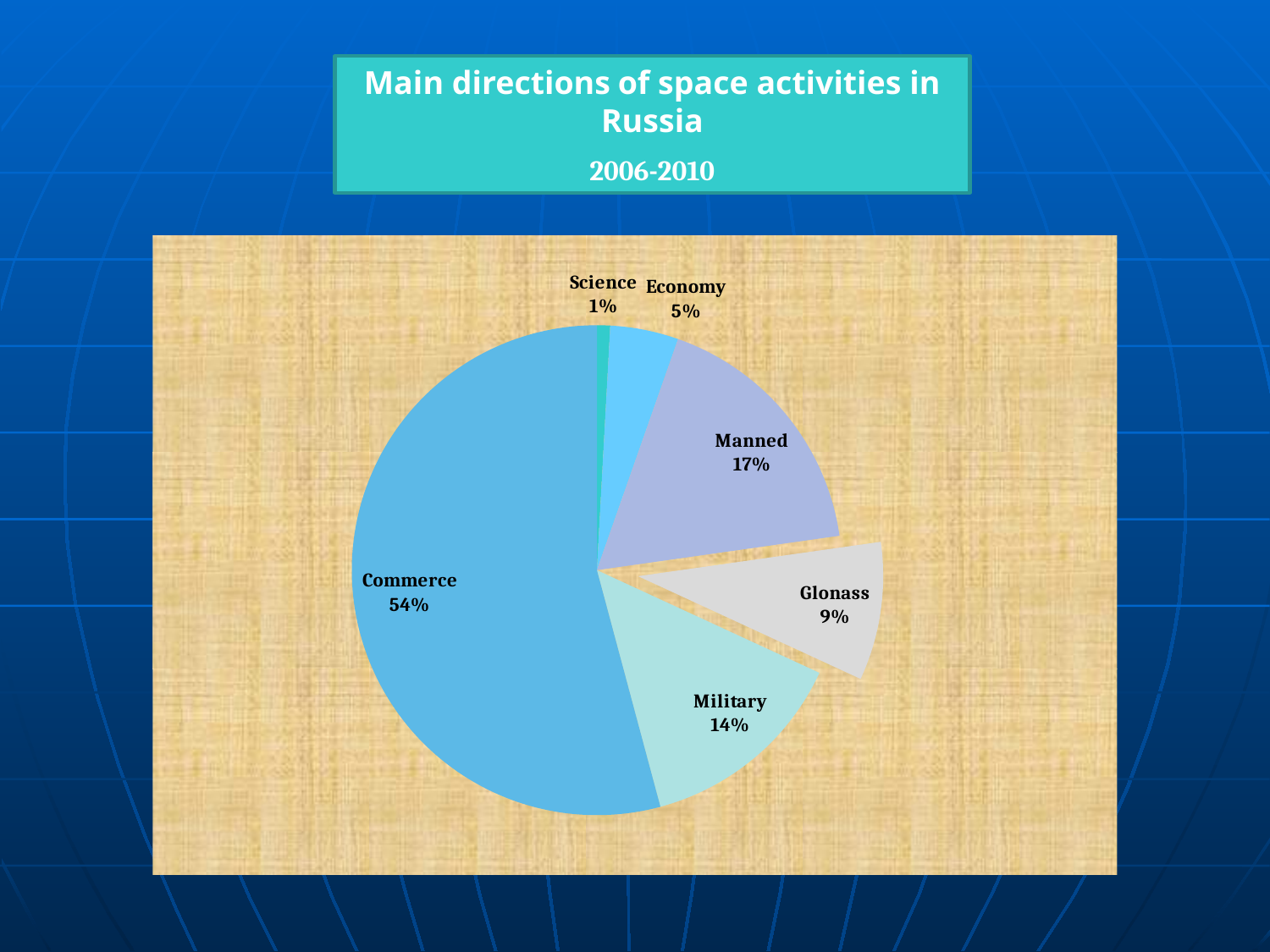
Which category has the largest slice of the pie? Commerce What time period does the chart title refer to? 2006-2010 What percentage is shown for Science? 1% How many categories are shown in the pie chart? 6 What share of the pie does Commerce account for? 54% Which category has the smallest slice of the pie? Science Which is larger, Economy or Glonass? Glonass What is the combined share of Military and Glonass? 23% What is the difference in percentage points between Manned and Military? 3 What percentage is shown for Manned? 17% What kind of chart is shown on the slide? Pie chart What is the value for Glonass? 9%